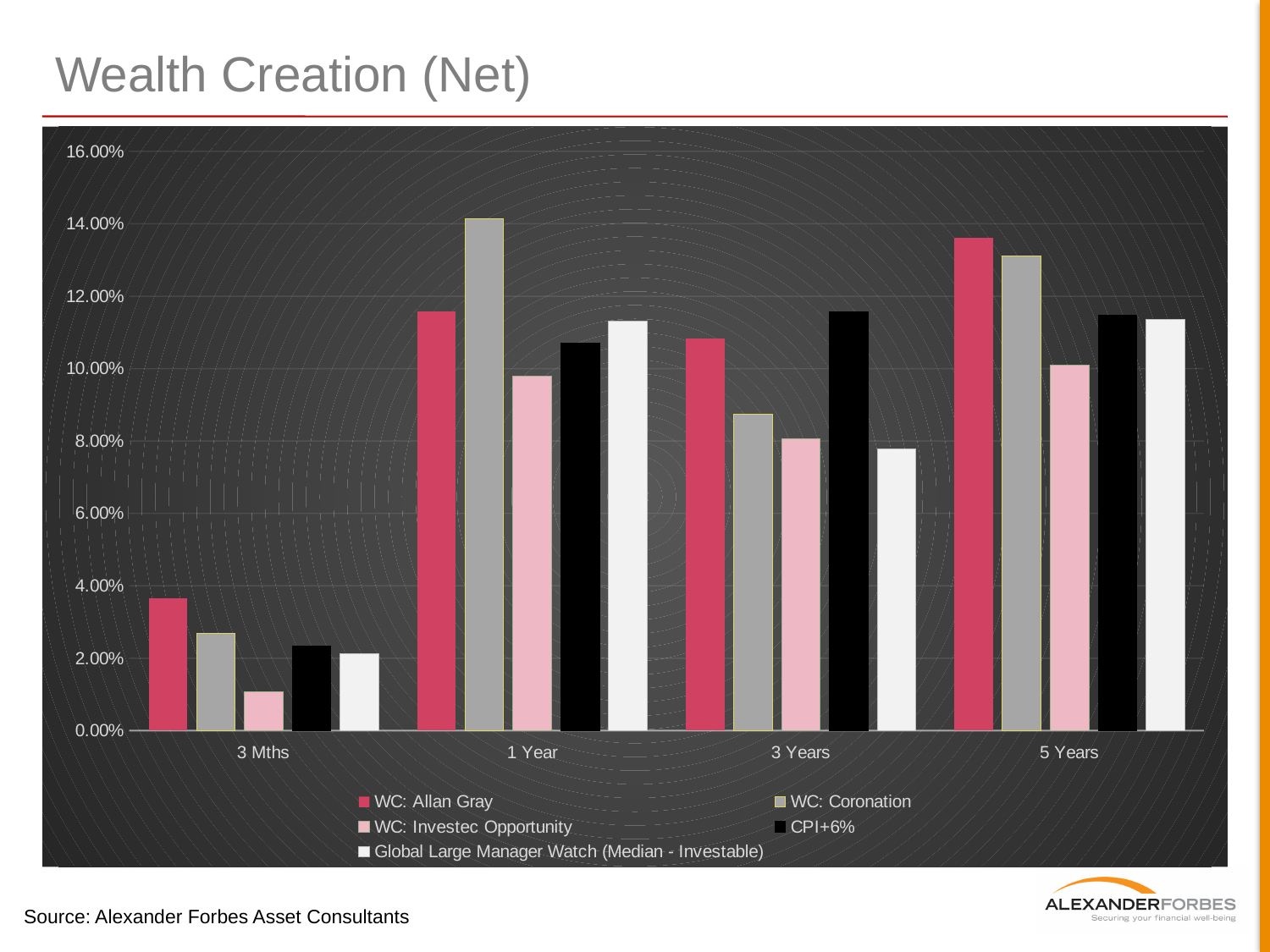
What is the title of the slide containing the chart? Wealth Creation (Net) Is the value for WC: Coronation at 1 Year greater or less than 12.00%? greater What kind of chart is shown on the slide? Bar chart Which series has the highest value for 1 Year? WC: Coronation How many series does the legend list? 5 Which series has the lowest value for 3 Mths? WC: Investec Opportunity For 3 Years, which is larger: WC: Allan Gray or WC: Coronation? WC: Allan Gray How many time-period categories are shown on the x axis? 4 Which series has the lowest value for 5 Years? WC: Investec Opportunity Is the value for WC: Allan Gray at 3 Mths greater or less than 4.00%? less Is the value for WC: Investec Opportunity at 5 Years greater or less than 8.00%? greater Which series has the highest value for 3 Years? CPI+6%